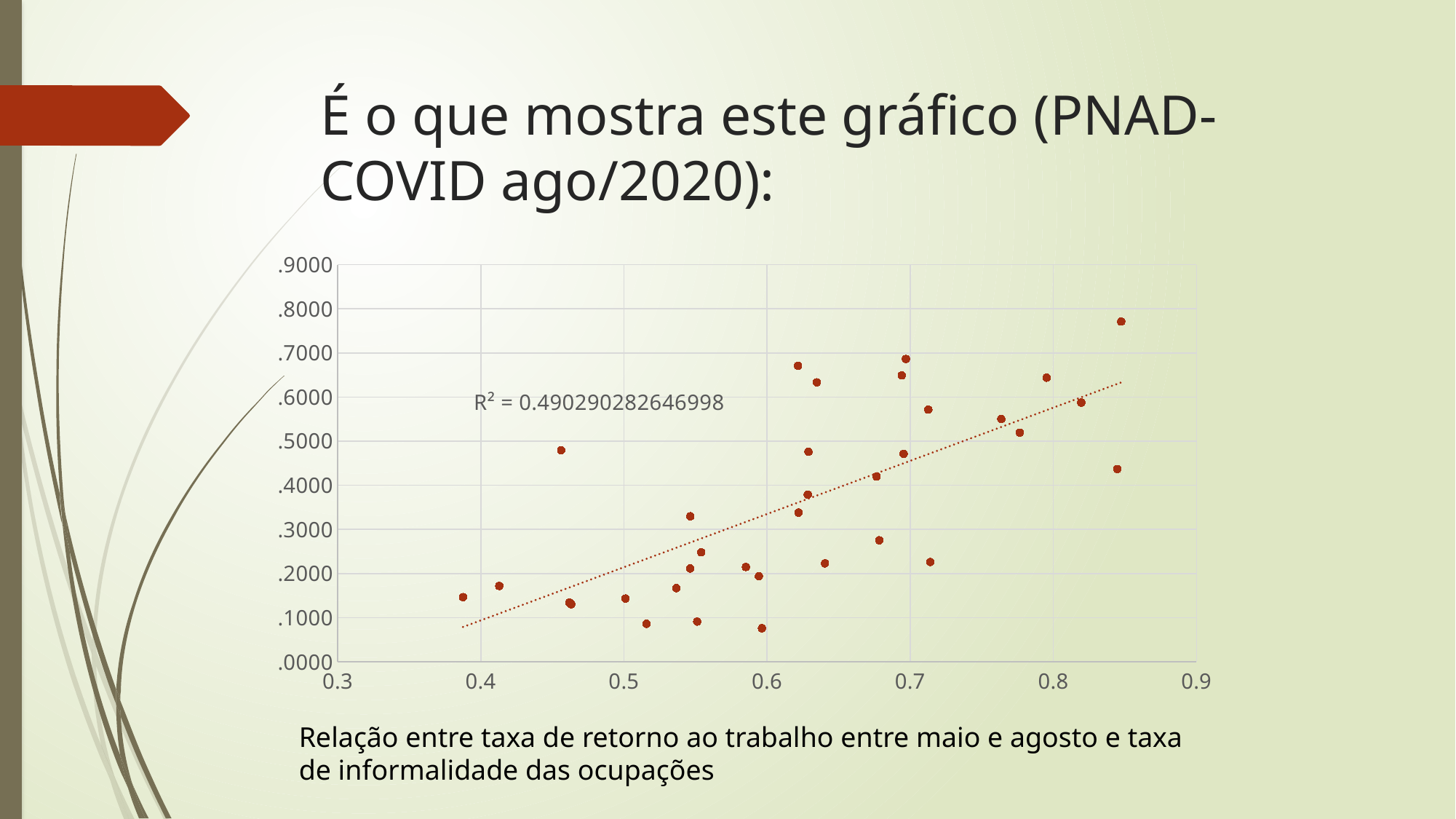
Does the chart include a dotted trend line through the points? yes Is the y value of the lowest point on the chart greater or less than .1000? less Is the x value of the highest point on the chart greater or less than 0.8? greater Is the y value of the leftmost point on the chart greater or less than .2000? less What R² value is printed on the chart? R² = 0.490290282646998 Do the plotted values generally rise or fall as the x-axis value increases? rise What kind of chart is shown on the slide? scatter plot